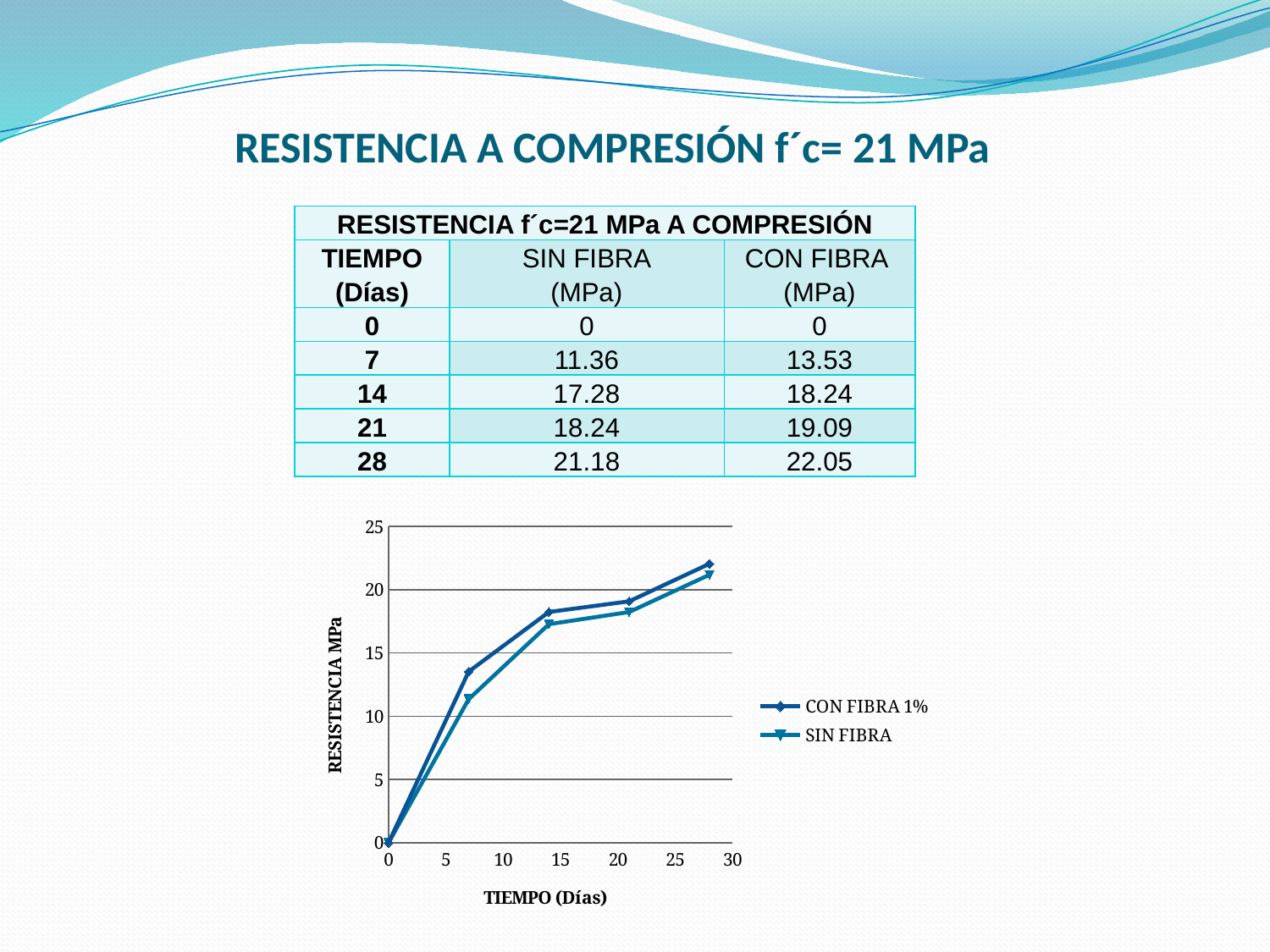
What is the label of the y axis of the chart? RESISTENCIA MPa According to the slide, what is the difference between CON FIBRA and SIN FIBRA at 7 days? 2.17 According to the slide, what is the resistance with fibre (CON FIBRA) at 14 days? 18.24 What kind of chart is shown on the slide? line chart Is the value for CON FIBRA 1% at 28 days greater or less than 20? greater Do the values in the chart rise or fall as time (días) increases? rise Is the value for SIN FIBRA at 7 days greater or less than 15? less According to the slide, what is the resistance without fibre (SIN FIBRA) at 28 days? 21.18 How many series does the chart legend list? 2 Which series is higher at 7 days, CON FIBRA 1% or SIN FIBRA? CON FIBRA 1% What are the two series named in the chart legend? CON FIBRA 1% and SIN FIBRA How many data points does each line in the chart have? 5